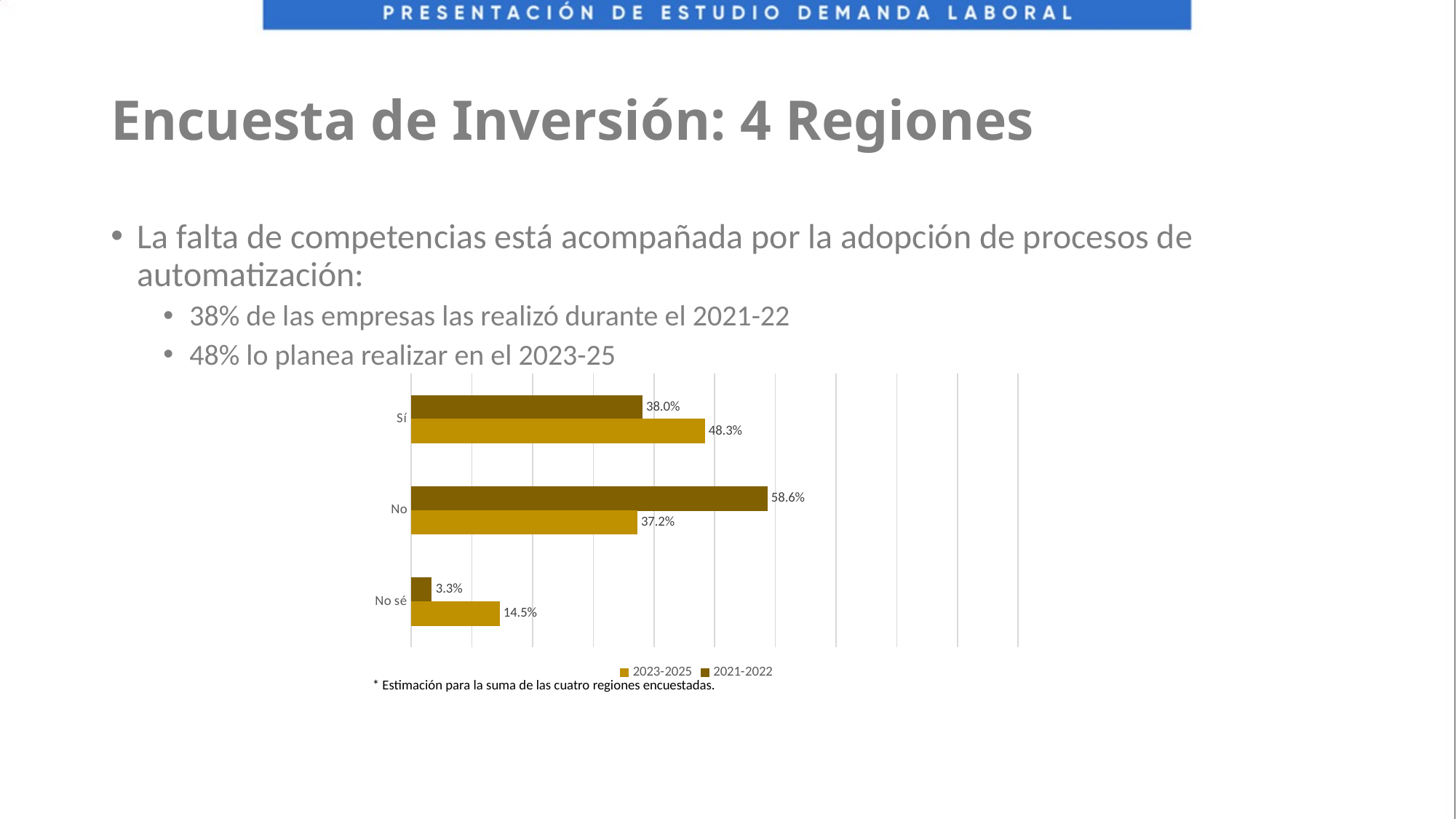
What is the value for "No" in the 2021-2022 series? 58.6% For "No sé", which series has the larger value, 2021-2022 or 2023-2025? 2023-2025 What is the value for "Sí" in the 2021-2022 series? 38.0% What is the value for "Sí" in the 2023-2025 series? 48.3% Which category has the lowest value in the 2023-2025 series? No sé What is the value for "No sé" in the 2023-2025 series? 14.5% Which category has the highest value in the 2021-2022 series? No How many categories are shown on the chart? 3 How many series does the legend list? 2 What is the difference between the 2021-2022 and 2023-2025 values for "No"? 21.4 percentage points What is the difference between the 2023-2025 and 2021-2022 values for "Sí"? 10.3 percentage points What kind of chart is shown on the slide? Bar chart